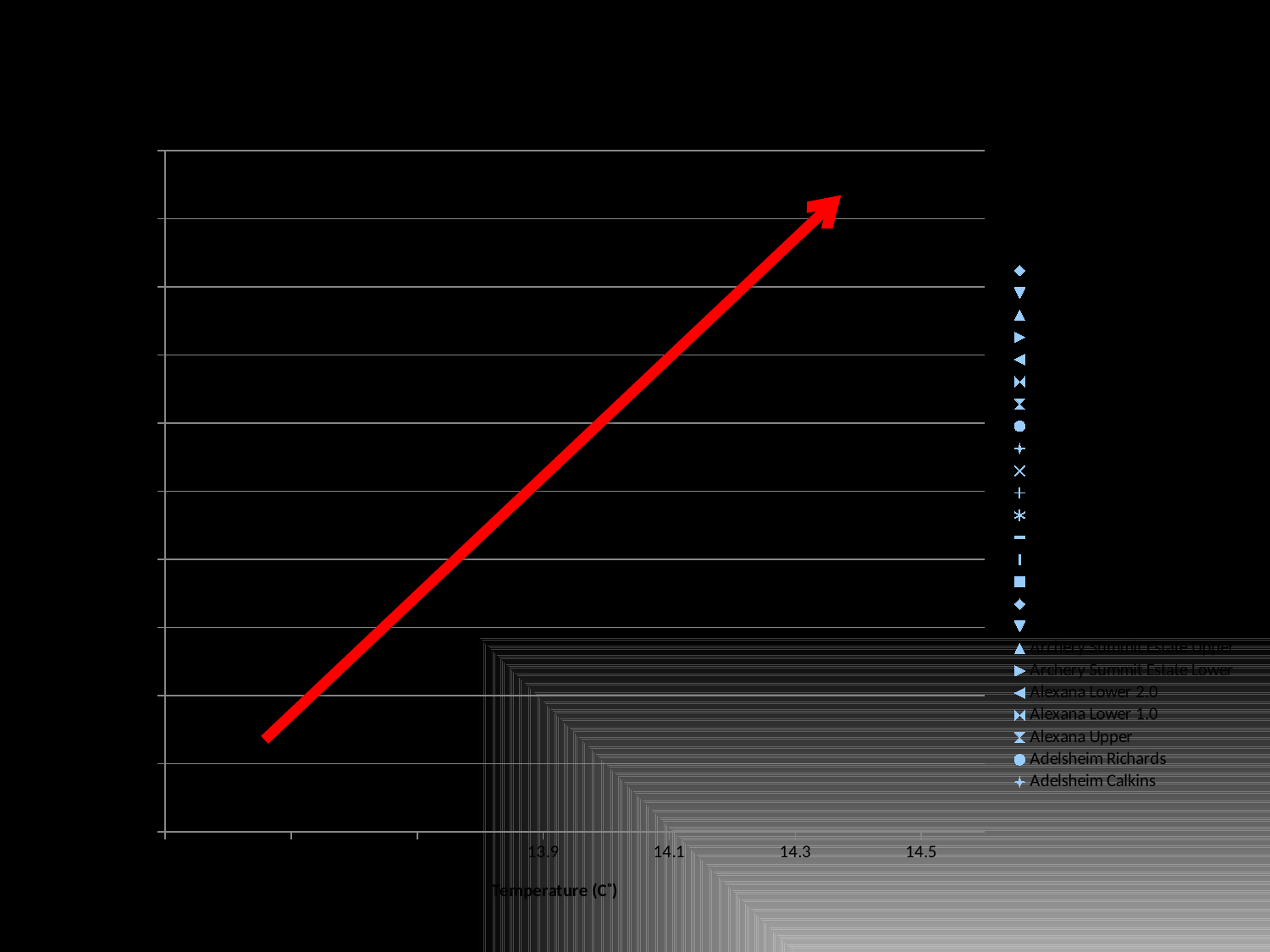
According to the red arrow drawn on the chart, do values rise or fall as temperature increases along the x axis? rise What kind of chart is shown on the slide? scatter chart What is the title of the x axis? Temperature (C°) Which legend entry is listed last at the bottom of the legend? Adelsheim Calkins